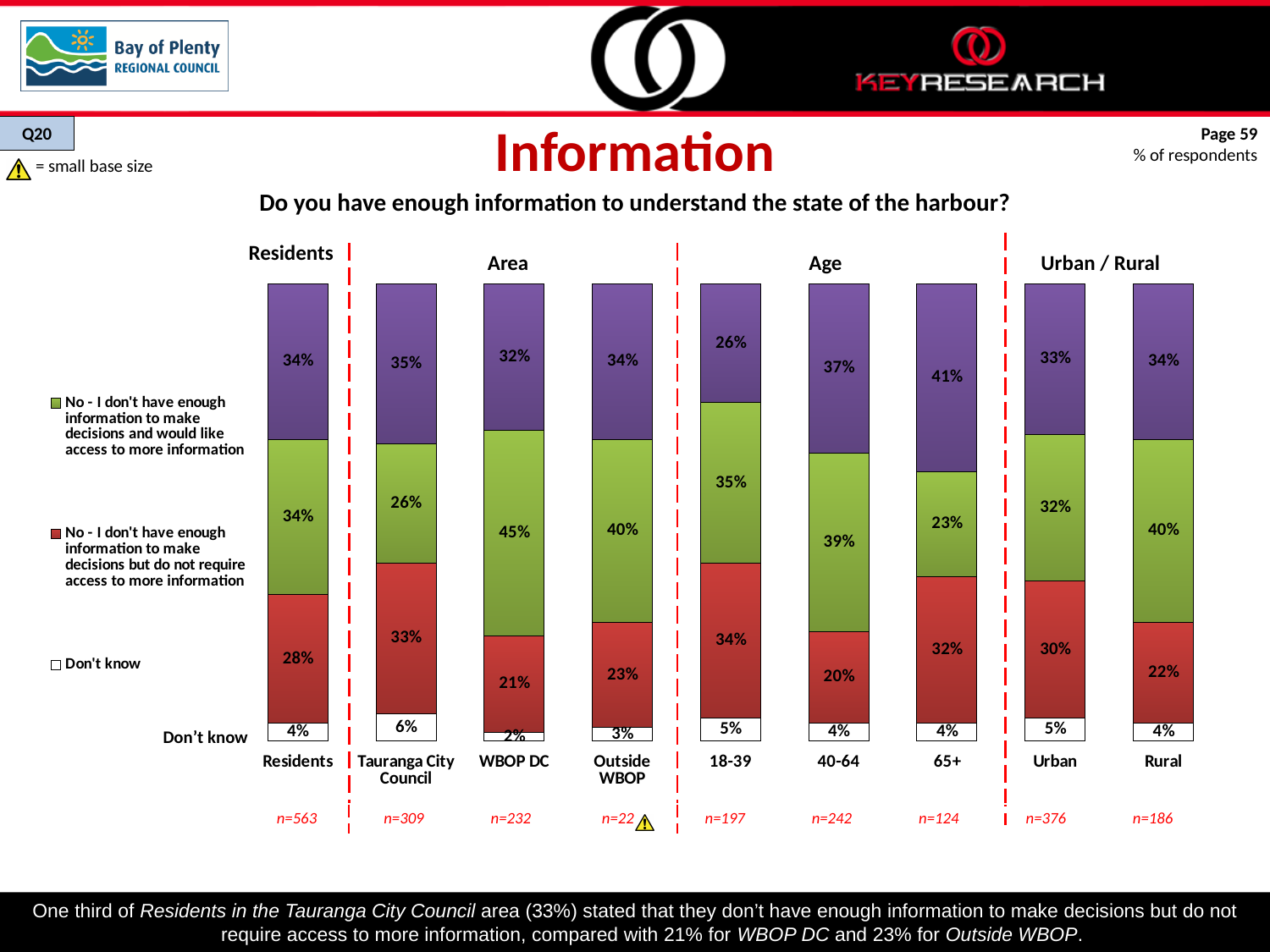
What is the difference between Tauranga City Council and WBOP DC in the "No - I don't have enough information to make decisions but do not require access to more information" series? 12 percentage points What percentage of Tauranga City Council respondents answered "Don't know"? 6% Which category has the lowest "Don't know" value? WBOP DC What is the value for WBOP DC in the "No - I don't have enough information to make decisions and would like access to more information" series? 45% What kind of chart is shown on the slide? Stacked bar chart What is the total of the stacked bar for Residents? 100% Which category has the highest value in the top (purple) segment of the stacked bars? 65+ Which has the larger value for "No - I don't have enough information to make decisions but do not require access to more information": 18-39 or 40-64? 18-39 Which category has the highest value for "No - I don't have enough information to make decisions and would like access to more information"? WBOP DC What is the sample size (n) shown for the Outside WBOP category? n=22 What is the value for the 65+ age group in the "No - I don't have enough information to make decisions but do not require access to more information" series? 32% How many categories are shown along the x axis of the chart? 9